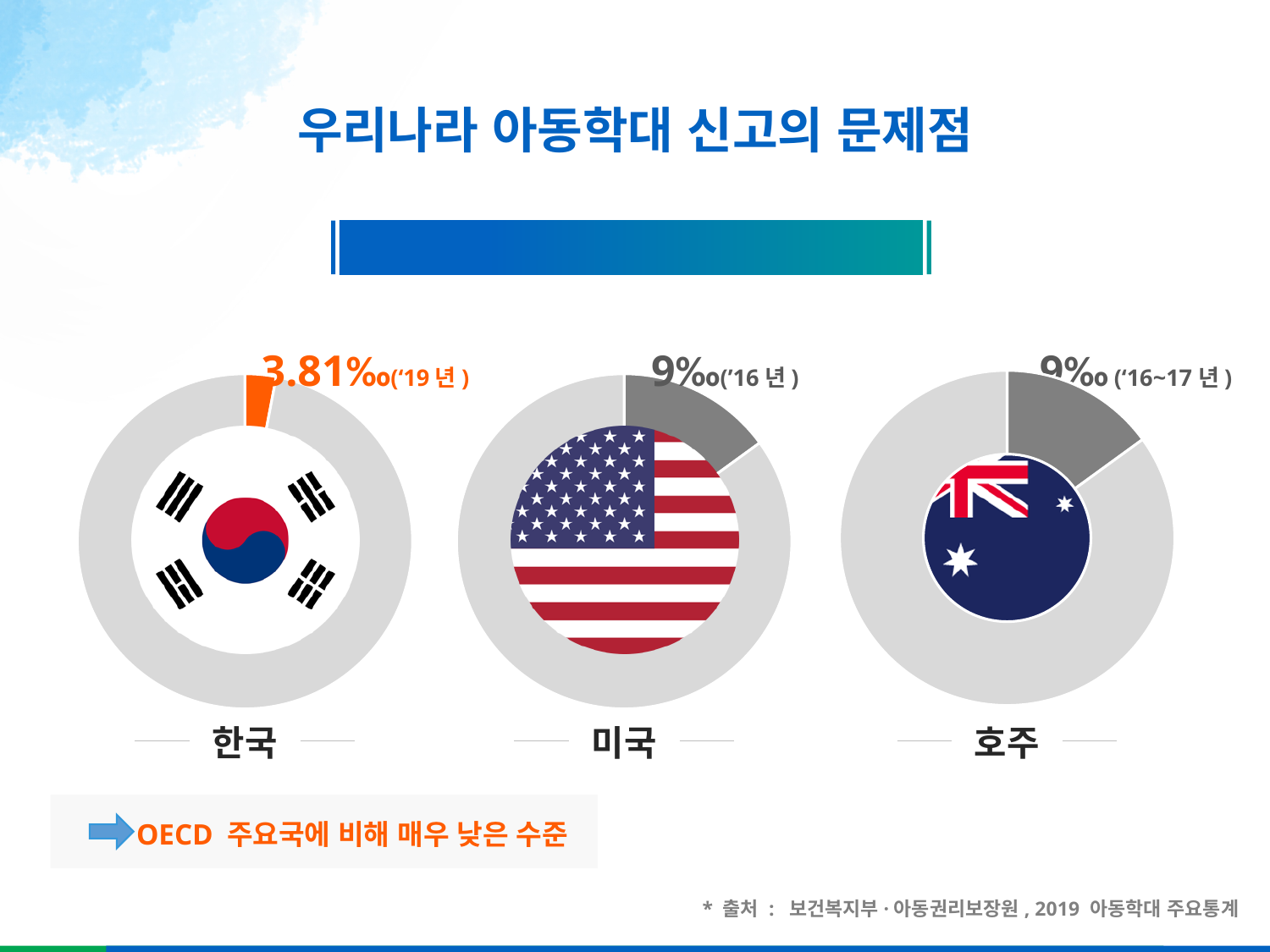
How many donut charts are shown on the slide? 3 Which country has the lowest value among the three donut charts? 한국 What value is shown for the 한국 (Korea) donut chart? 3.81‰ What is the difference between the value for 미국 and the value for 한국? 5.19‰ Which period is given next to the value for the 호주 chart? '16~17년 Which is larger, the value for 한국 or the value for 미국? 미국 Which is larger, the value for 호주 or the value for 한국? 호주 Which year is given next to the value for the 한국 chart? '19년 What value is shown for the 호주 (Australia) donut chart? 9‰ What value is shown for the 미국 (USA) donut chart? 9‰ What kind of chart is used to show each country's value? Donut (pie) chart What colour is the highlighted slice in the 한국 donut chart? Orange